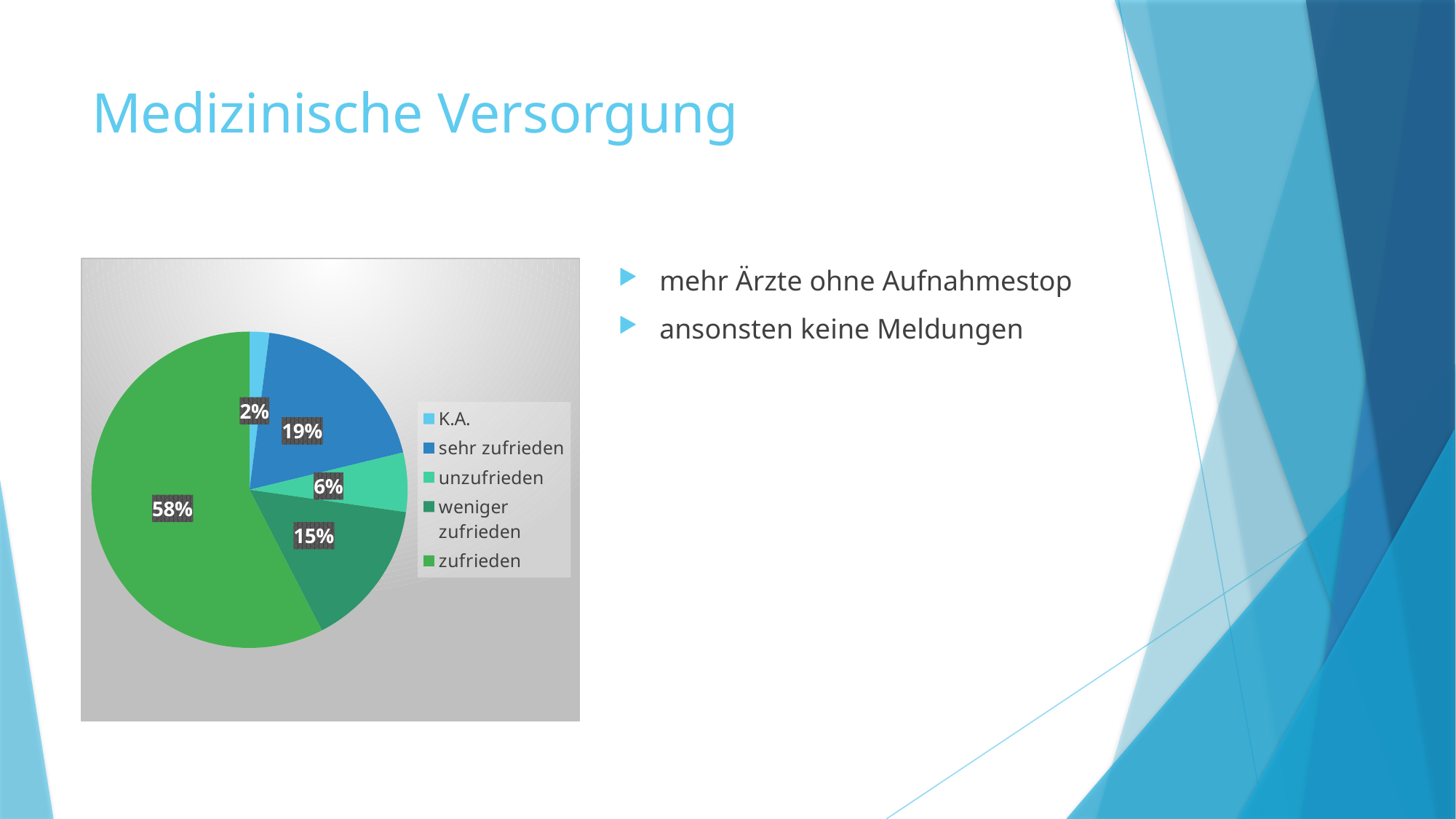
What share of the pie does "weniger zufrieden" have? 15% Which category has the smallest slice of the pie? K.A. How many categories does the pie chart have? 5 What share of the pie does "unzufrieden" have? 6% Which is larger, the share for "weniger zufrieden" or the share for "unzufrieden"? weniger zufrieden What share of the pie does "sehr zufrieden" have? 19% Which category has the largest slice of the pie? zufrieden What kind of chart is shown on the slide? pie chart What is the difference in percentage points between "zufrieden" and "sehr zufrieden"? 39 What colour is the "zufrieden" slice in the pie chart? green